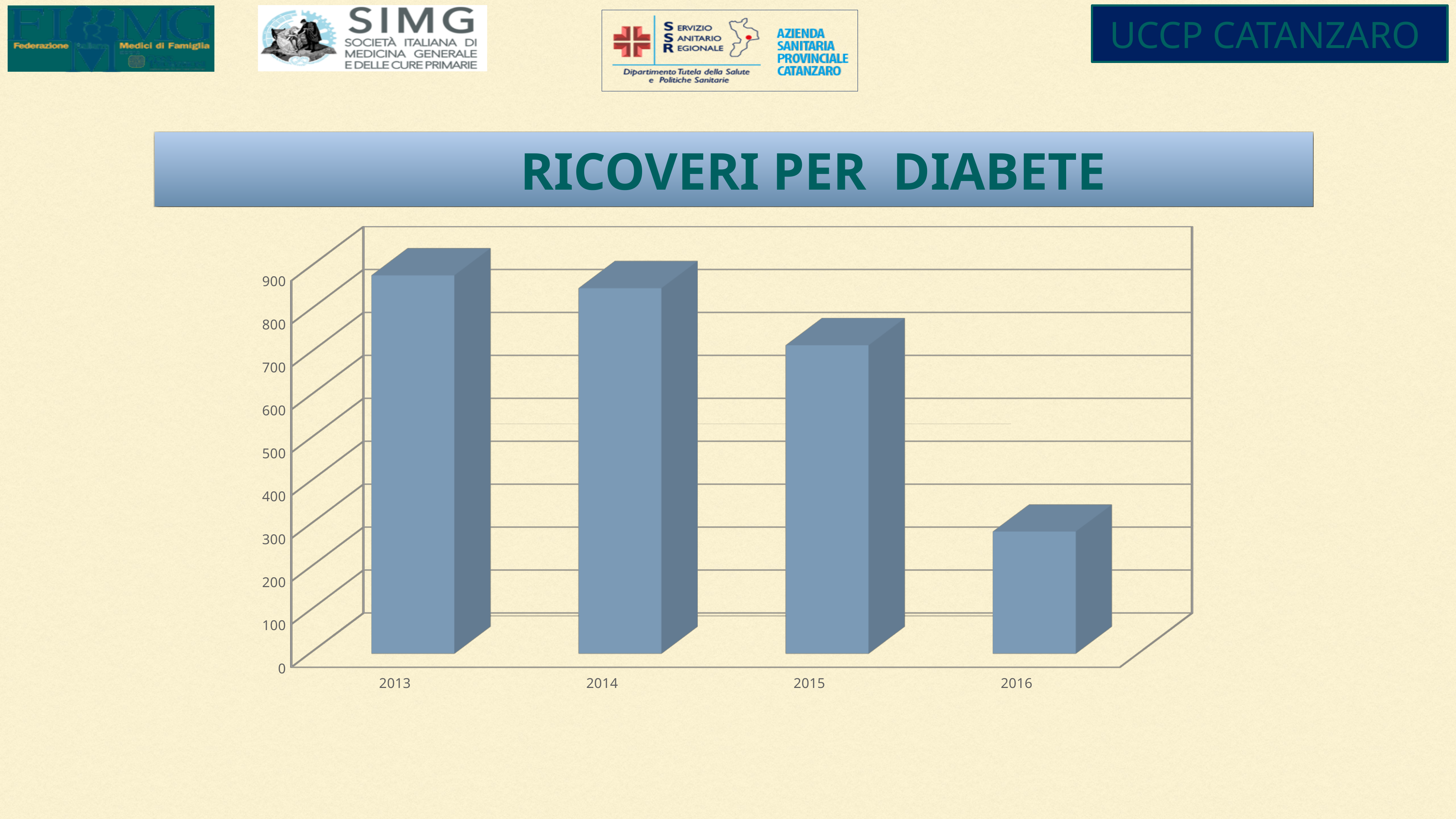
Which is larger, the value for 2014 or the value for 2015? 2014 Which year has the lowest value in the chart? 2016 Is the value for 2014 greater or less than 800? greater Is the value for 2015 greater or less than 800? less Which year has the highest value in the chart? 2013 Is the value for 2016 greater or less than 400? less Do the values rise or fall from 2013 to 2016? fall What kind of chart is shown on the slide? bar chart Which is larger, the value for 2015 or the value for 2016? 2015 How many years are shown on the x axis of the chart? 4 What is the title of the chart? RICOVERI PER DIABETE